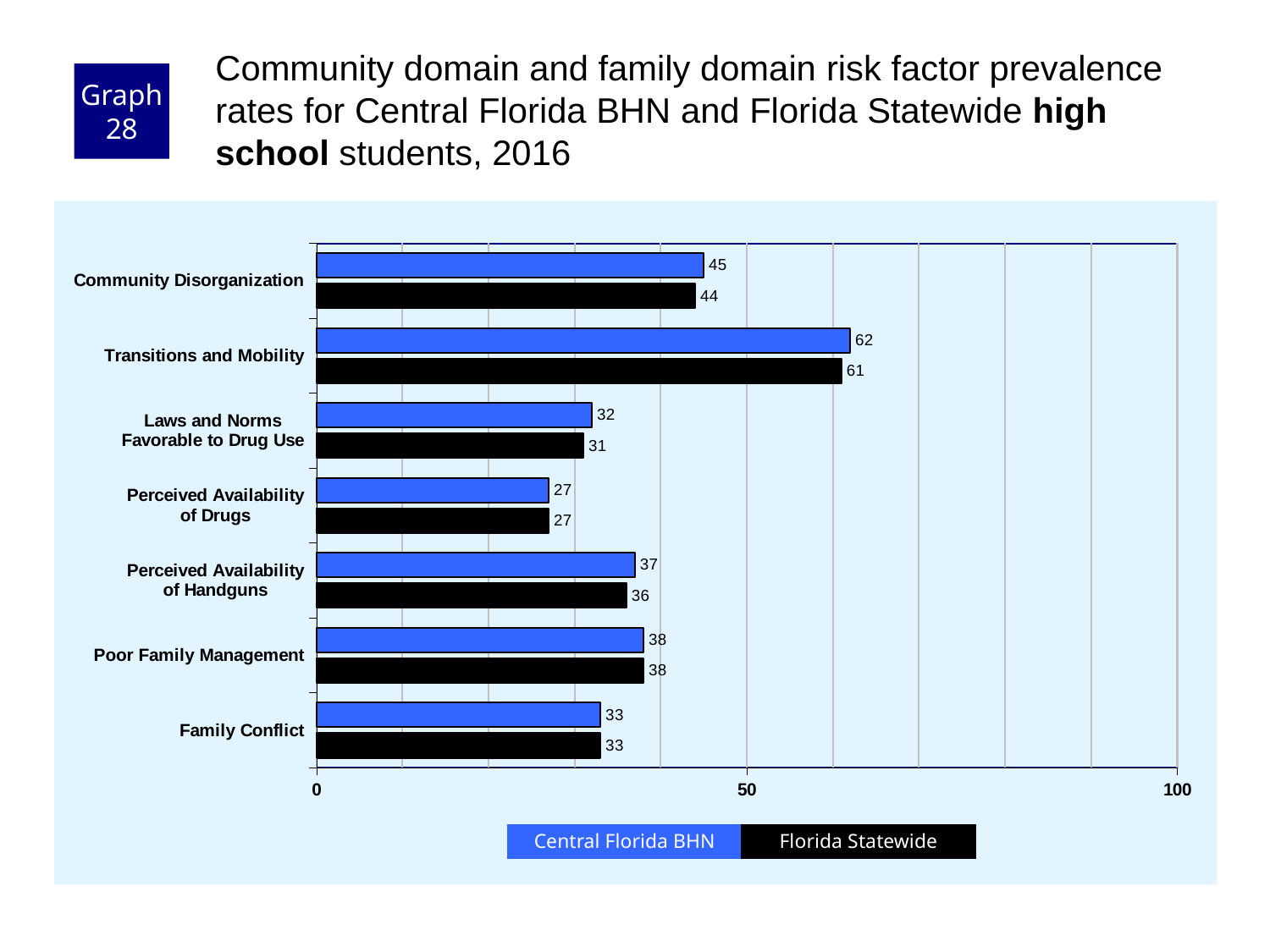
How many series does the legend list? 2 What is the difference between the Central Florida BHN and Florida Statewide values for Transitions and Mobility? 1 What kind of chart is shown on the slide? bar chart How many risk factor categories are shown on the chart? 7 Is the Central Florida BHN value for Transitions and Mobility greater or less than 50? greater What is the Florida Statewide value for Community Disorganization? 44 Which colour represents Florida Statewide in the chart? black Which risk factor has the highest Central Florida BHN value? Transitions and Mobility Which risk factor has the lowest Florida Statewide value? Perceived Availability of Drugs What is the difference between the Central Florida BHN values for Transitions and Mobility and Community Disorganization? 17 What is the Florida Statewide value for Laws and Norms Favorable to Drug Use? 31 What is the Central Florida BHN value for Transitions and Mobility? 62